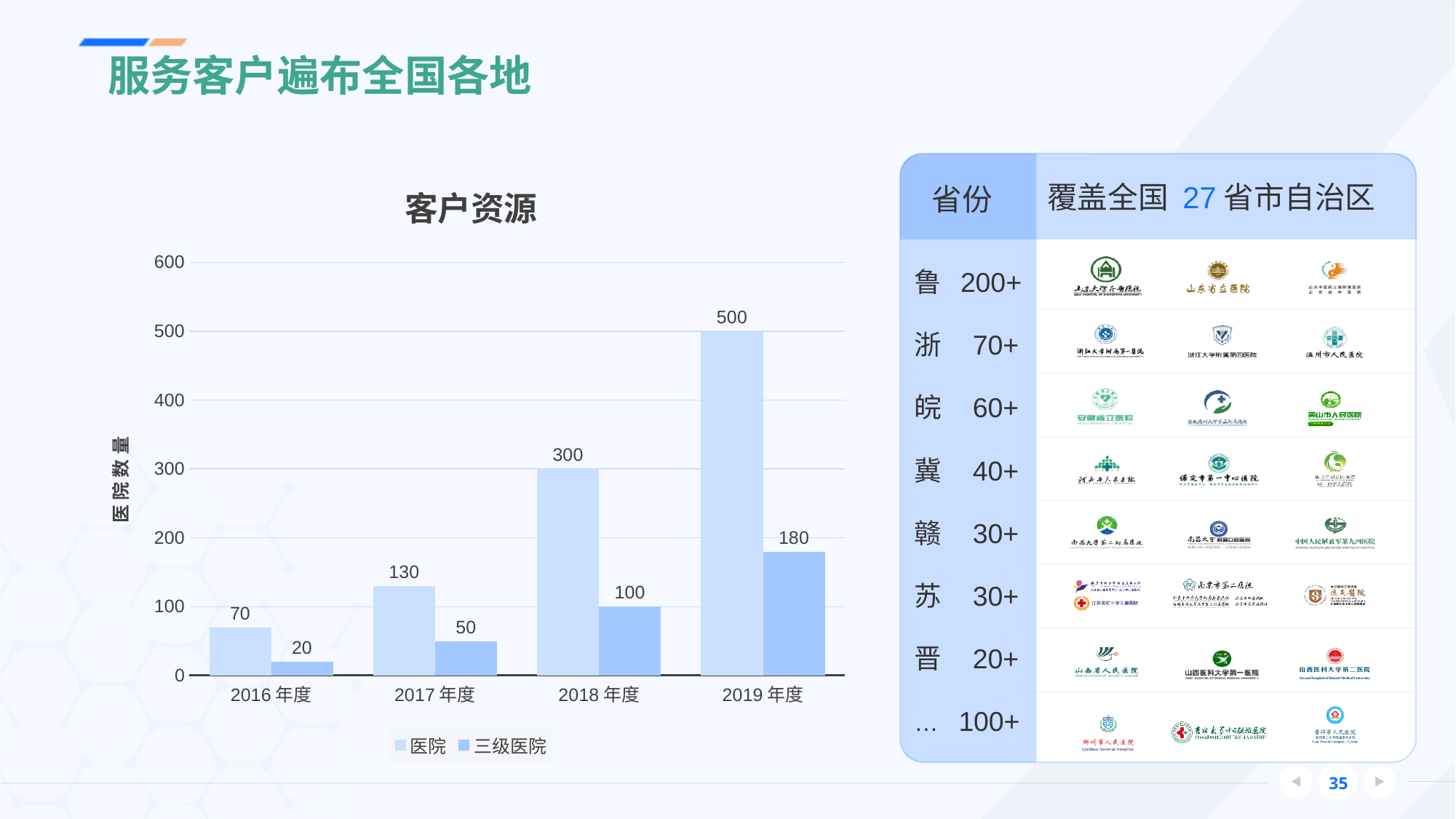
Which year has the lowest value for 医院? 2016 年度 What is the value for 三级医院 in 2017 年度? 50 What is the title of the chart? 客户资源 What is the difference between 医院 and 三级医院 in 2018 年度? 200 How many series does the legend list? 2 Do the values for 医院 rise or fall from 2016 年度 to 2019 年度? rise What kind of chart is shown? bar chart Which year has the highest value for 三级医院? 2019 年度 Which is larger: 医院 in 2017 年度 or 三级医院 in 2019 年度? 三级医院 in 2019 年度 How many years are shown on the x axis? 4 What is the value for 医院 in 2019 年度? 500 What is the value for 医院 in 2016 年度? 70